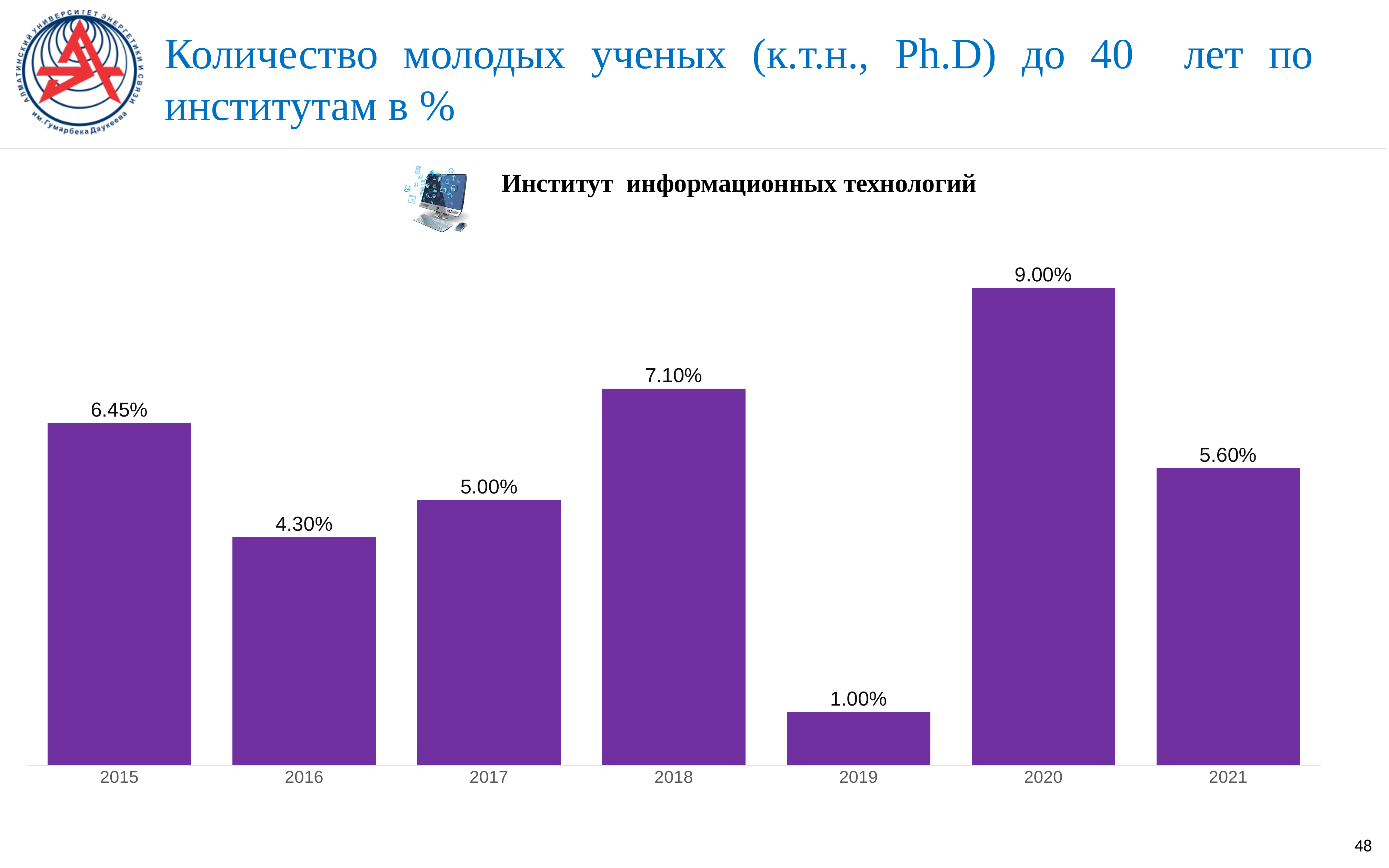
Which year has the highest value? 2020 What is the value for 2015? 6.45% What is the difference between the values for 2018 and 2017? 2.10% Which is larger, the value for 2016 or the value for 2021? 2021 What is the value for 2021? 5.60% Do the values rise or fall from 2016 to 2018? Rise What kind of chart is this? Bar chart What is the value for 2019? 1.00% How many years are shown on the x axis? 7 What is the difference between the values for 2020 and 2019? 8.00% Which institute does the chart refer to? Институт информационных технологий Which year has the lowest value? 2019